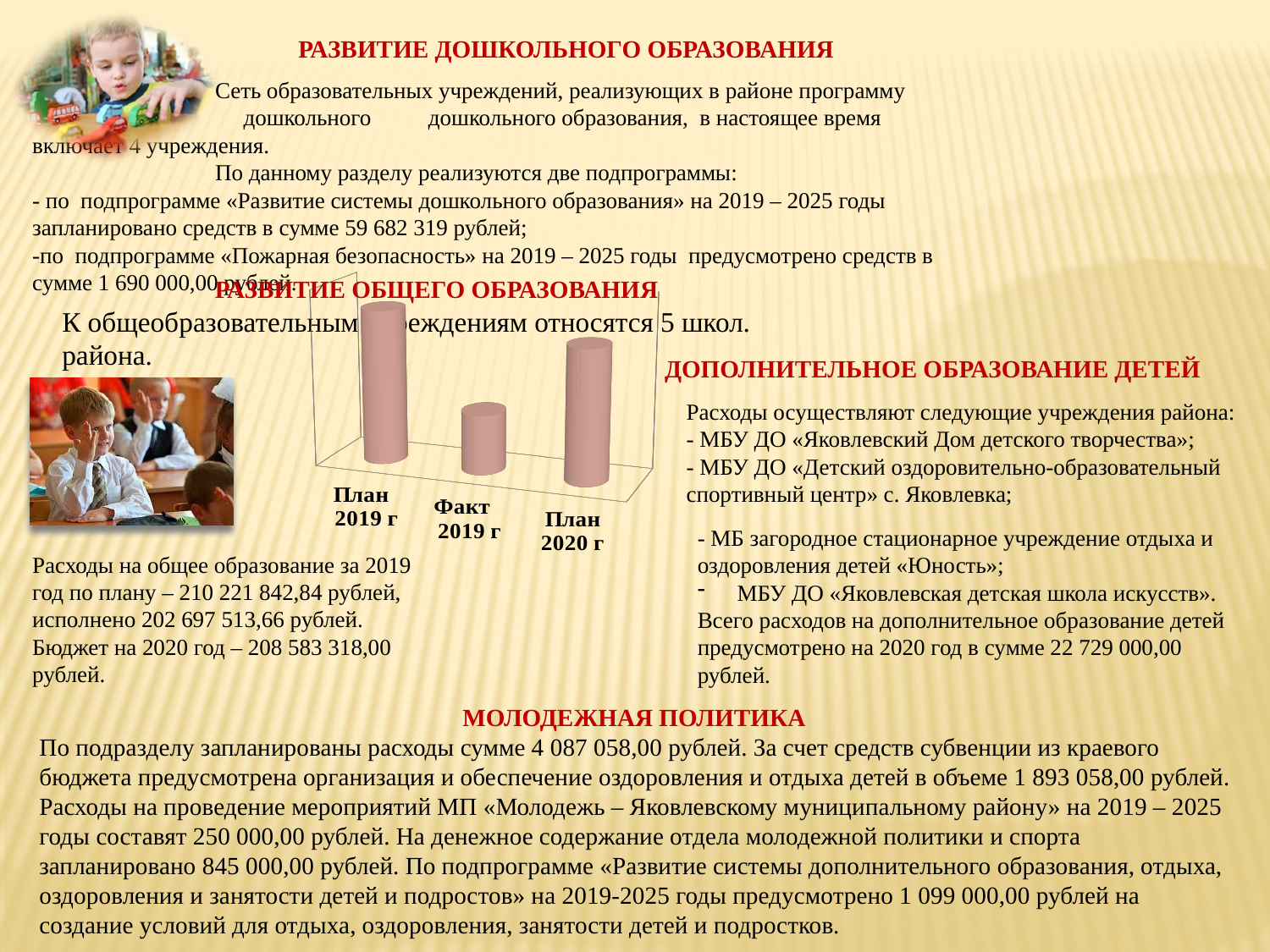
In the chart, which is larger: План 2019 г or План 2020 г? План 2019 г What kind of chart is shown on the slide? bar chart Which category has the tallest bar in the chart? План 2019 г How many bars does the chart on the slide have? 3 In the chart, which is larger: Факт 2019 г or План 2020 г? План 2020 г Which category has the shortest bar in the chart? Факт 2019 г What are the three category labels under the bars of the chart? План 2019 г, Факт 2019 г, План 2020 г In the chart, which is larger: План 2019 г or Факт 2019 г? План 2019 г Does the chart on the slide show a legend? No